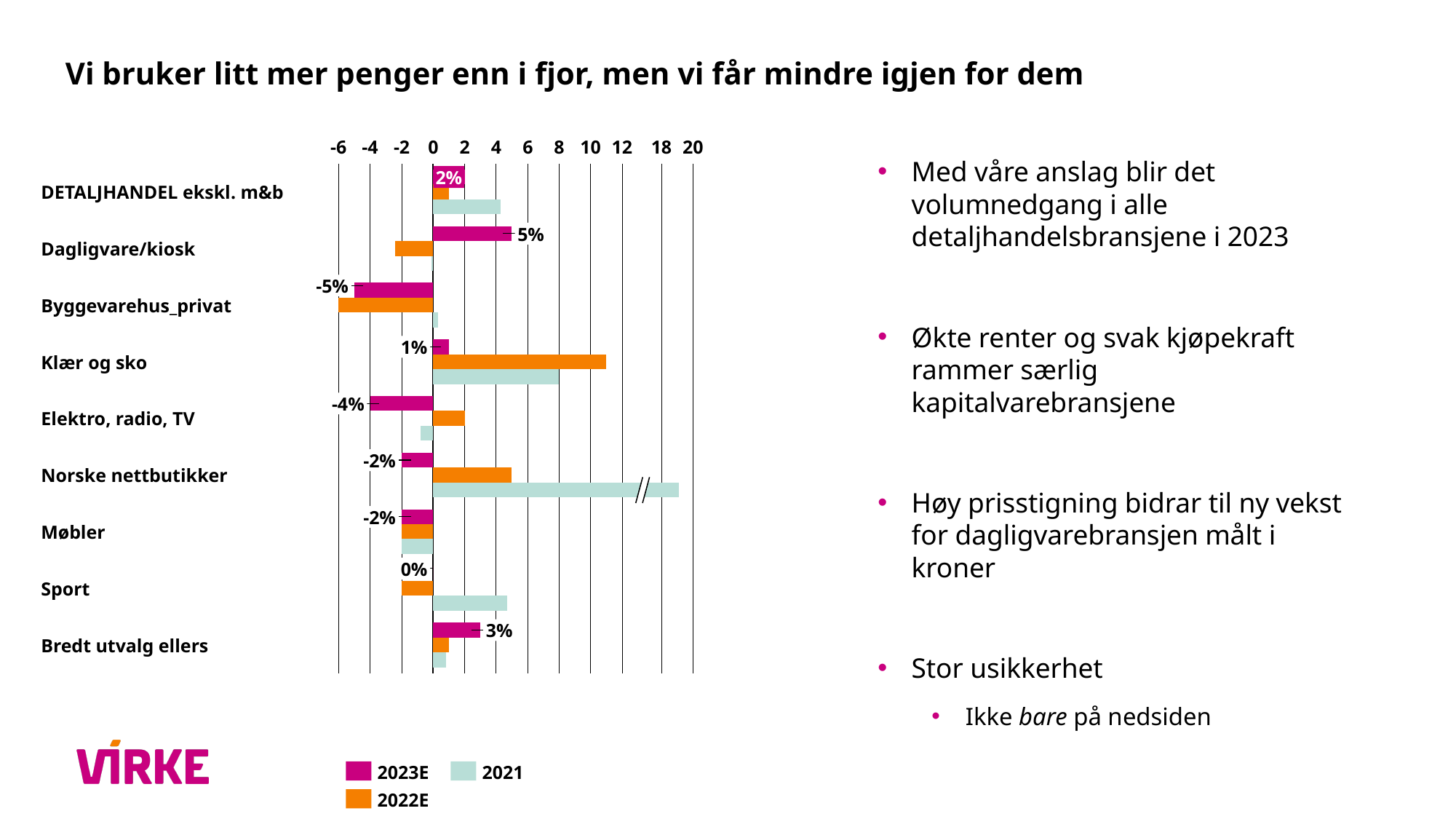
What is the difference between the 2023E values for Dagligvare/kiosk and Byggevarehus_privat? 10 percentage points Is the 2022E value for Klær og sko greater or less than 10? greater What is the 2023E value for Byggevarehus_privat? -5% How many categories are shown on the chart? 9 Which category has the highest 2023E value? Dagligvare/kiosk How many series does the legend list? 3 What is the 2023E value for Sport? 0% What is the 2023E value for Dagligvare/kiosk? 5% Which category has the lowest 2023E value? Byggevarehus_privat Which has the larger 2023E value, Bredt utvalg ellers or Klær og sko? Bredt utvalg ellers What is the 2023E value for Elektro, radio, TV? -4% What kind of chart is shown on the slide? Bar chart